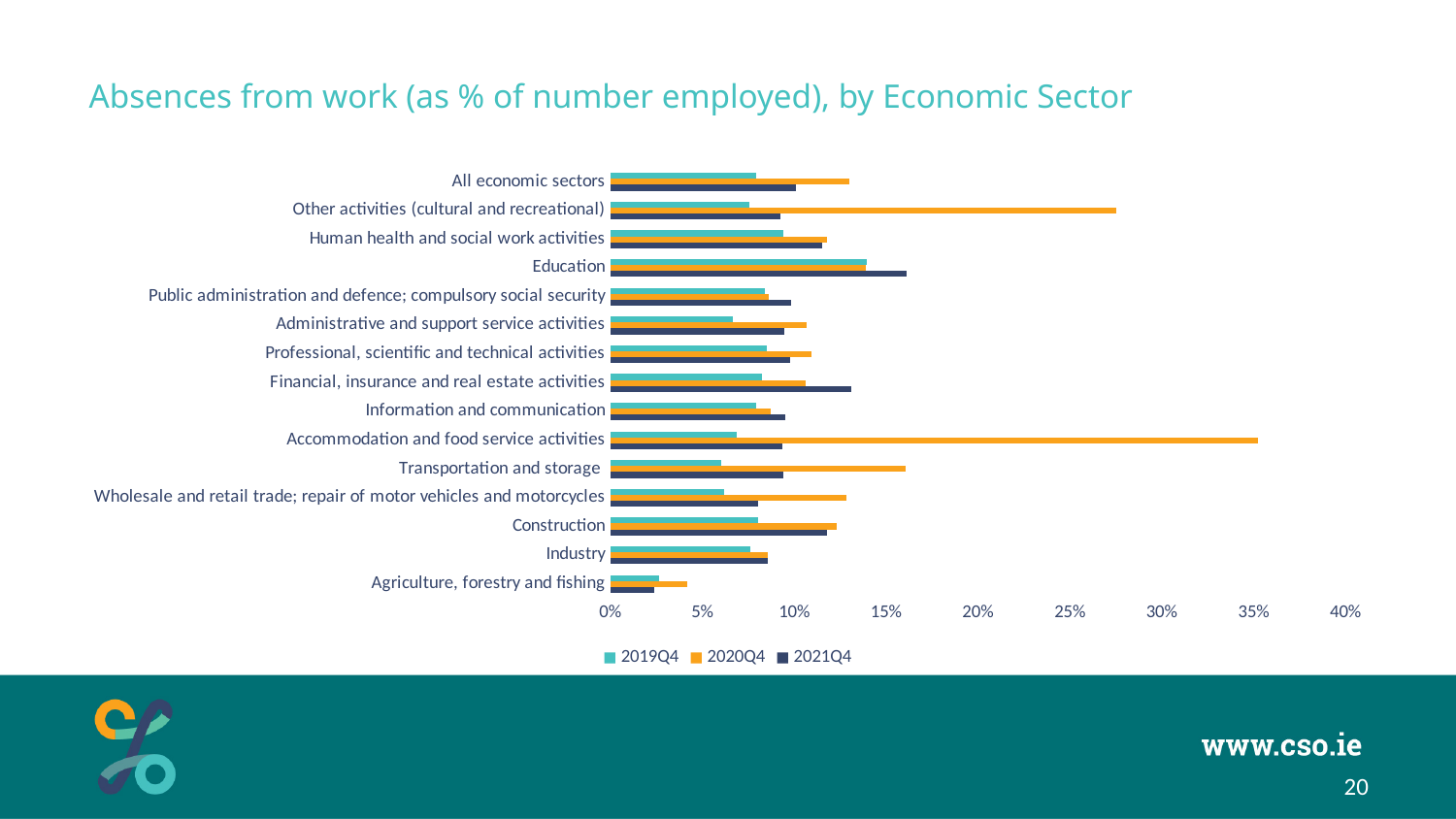
Is the 2019Q4 value for Agriculture, forestry and fishing greater or less than 5%? less How many economic sector categories are plotted on the chart? 15 What is the title of the chart? Absences from work (as % of number employed), by Economic Sector How many series does the legend list? 3 Which economic sector has the highest 2020Q4 absence rate? Accommodation and food service activities Which is larger for 2021Q4: Education or Industry? Education Is the 2021Q4 value for Education greater or less than 10%? greater What kind of chart is shown on the slide? Bar chart Is the 2020Q4 value for Accommodation and food service activities greater or less than 30%? greater Which is larger for 2020Q4: Accommodation and food service activities or Other activities (cultural and recreational)? Accommodation and food service activities Which economic sector has the lowest 2019Q4 absence rate? Agriculture, forestry and fishing